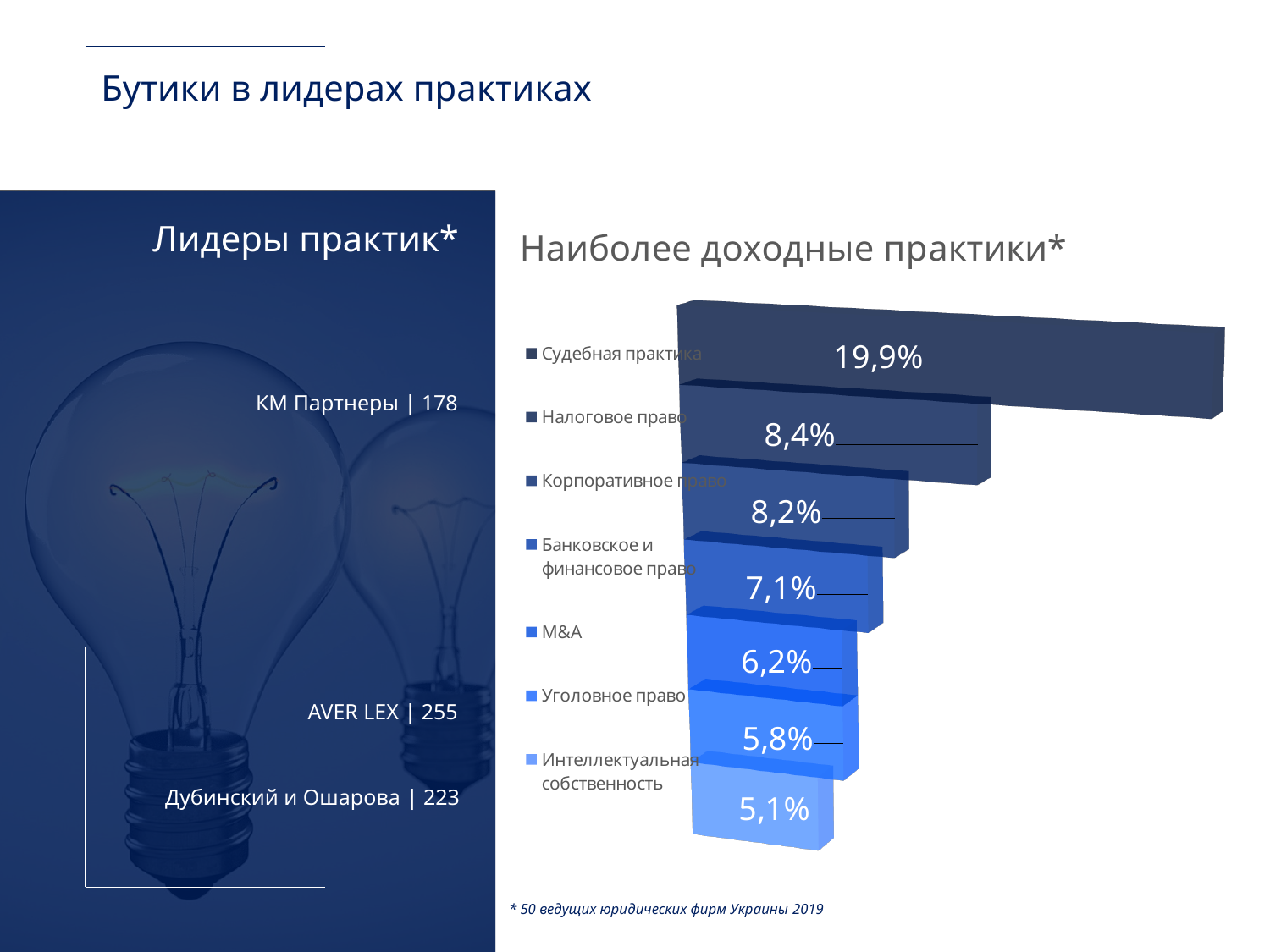
Which practice has the lowest value in the chart 'Наиболее доходные практики*'? Интеллектуальная собственность What is the value for Интеллектуальная собственность in the chart 'Наиболее доходные практики*'? 5,1% Which is larger in the chart 'Наиболее доходные практики*': Корпоративное право or M&A? Корпоративное право What is the value for M&A in the chart 'Наиболее доходные практики*'? 6,2% Which practice has the highest value in the chart 'Наиболее доходные практики*'? Судебная практика What kind of chart is 'Наиболее доходные практики*'? Bar chart What is the value for Судебная практика in the chart 'Наиболее доходные практики*'? 19,9% What is the difference between Судебная практика and Налоговое право in the chart 'Наиболее доходные практики*'? 11,5% What is the difference between Банковское и финансовое право and Уголовное право in the chart 'Наиболее доходные практики*'? 1,3% How many practices are shown in the chart 'Наиболее доходные практики*'? 7 What is the value for Налоговое право in the chart 'Наиболее доходные практики*'? 8,4% How many entries does the legend of the chart 'Наиболее доходные практики*' list? 7